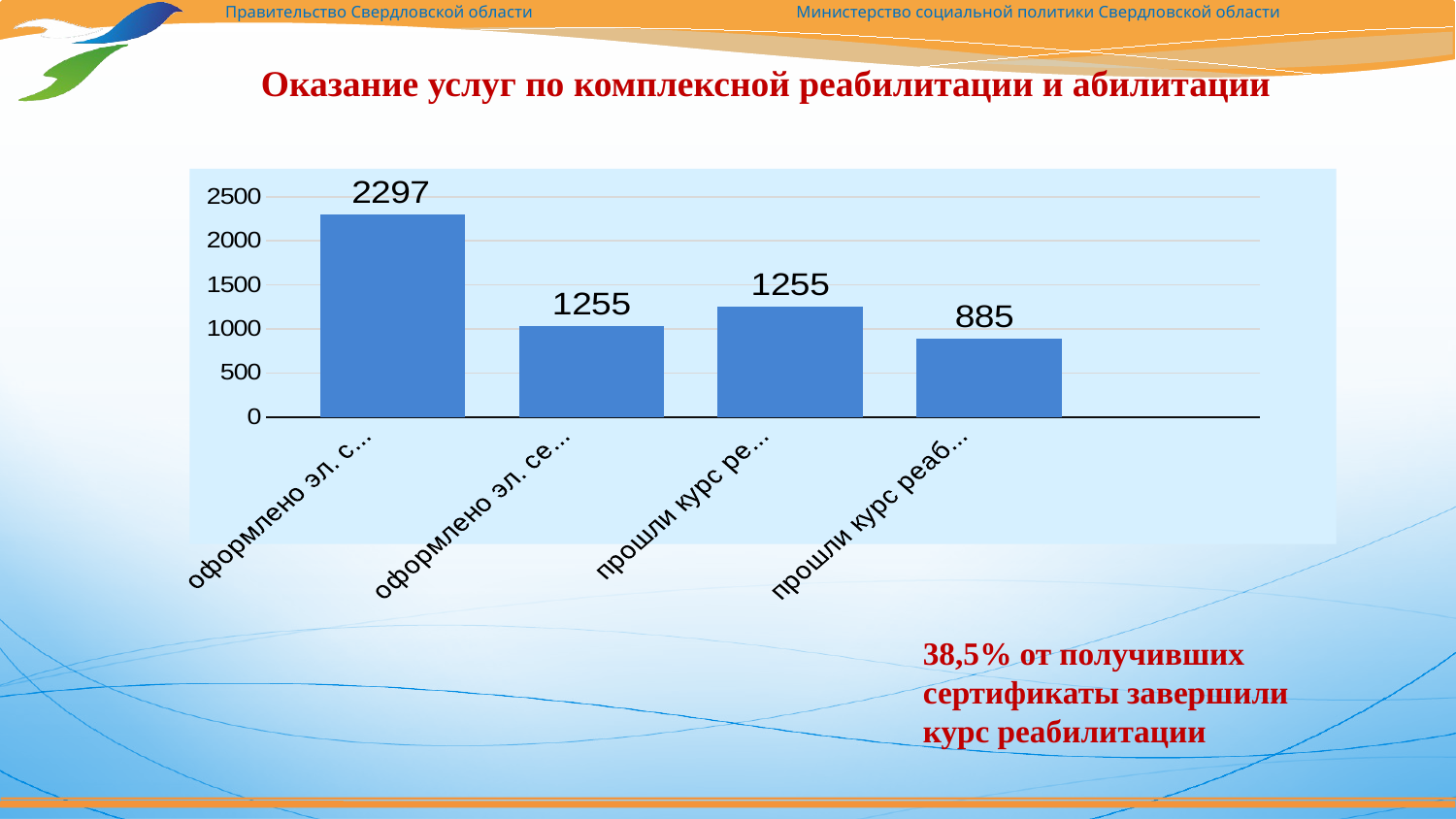
How many bars does the chart contain? 4 What is the title of the slide above the chart? Оказание услуг по комплексной реабилитации и абилитации Which is larger, the value of the first bar or the value of the third bar? the first bar Which bar has the lowest value? the fourth (rightmost) bar, 885 What is the value shown on the third bar? 1255 Do the values generally rise or fall from left to right across the bars? fall What type of chart is shown on the slide? bar chart What is the difference between the first bar (2297) and the fourth bar (885)? 1412 Which bar has the highest value? the first (leftmost) bar, 2297 What is the value shown on the fourth (rightmost) bar? 885 What is the value shown on the first (leftmost) bar? 2297 Is the value of the first bar greater or less than 2000? greater